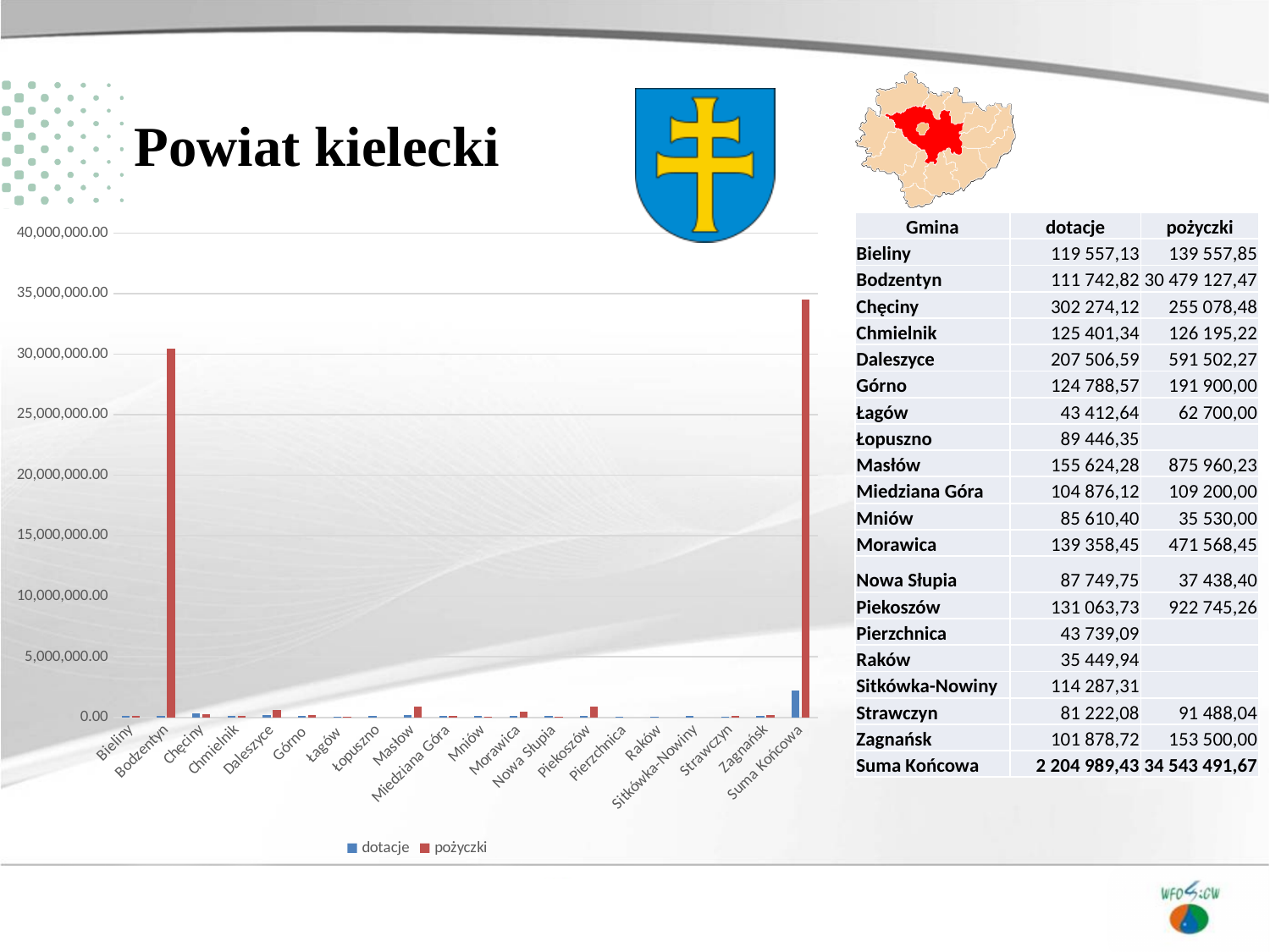
Excluding Suma Końcowa, which gmina has the tallest pożyczki bar? Bodzentyn Is the pożyczki value for Suma Końcowa greater or less than 30,000,000.00? greater What kind of chart is shown on the slide? bar chart Which colour represents the pożyczki series in the chart? red What is the dotacje value for Chęciny? 302 274,12 Is the pożyczki value for Bodzentyn greater or less than 25,000,000.00? greater What is the pożyczki value for Piekoszów? 922 745,26 How many series does the chart legend list? 2 What is the difference between the pożyczki and dotacje values for Bieliny? 20 000,72 What is the dotacje value for Suma Końcowa? 2 204 989,43 How many categories are shown along the x axis of the chart? 20 Which is larger, the pożyczki value for Bodzentyn or the pożyczki value for Masłów? Bodzentyn